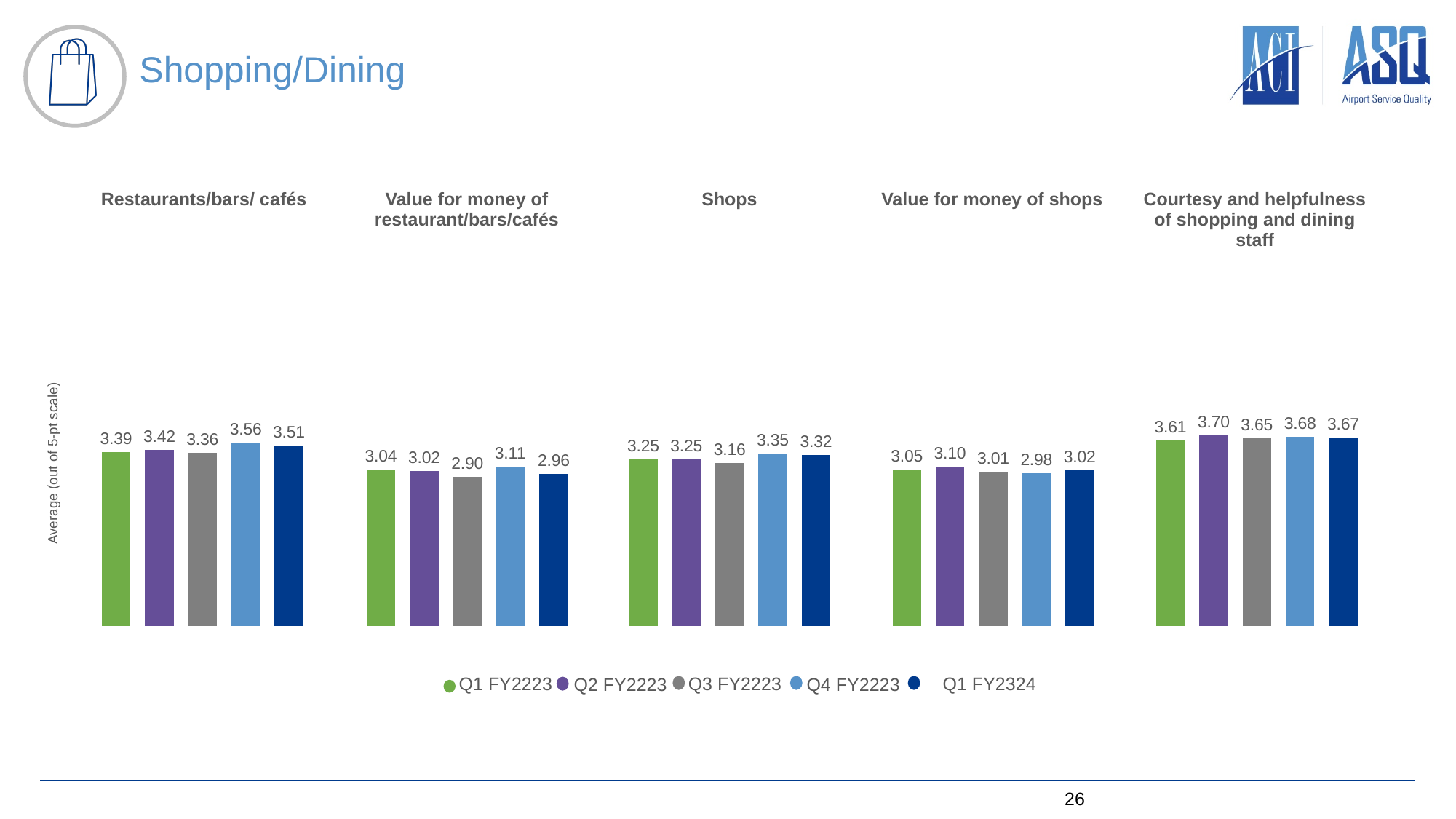
Which is larger in the Shops category: the Q3 FY2223 value or the Q4 FY2223 value? Q4 FY2223 How many categories are shown on the chart? 5 What is the value for Q1 FY2324 in the Shops category? 3.32 What kind of chart is shown on the slide? Bar chart What is the difference between the Q4 FY2223 and Q1 FY2324 values in the Restaurants/bars/ cafés category? 0.05 Which series has the lowest value in the Value for money of shops category? Q4 FY2223 What is the label of the vertical axis? Average (out of 5-pt scale) Which series has the highest value in the Courtesy and helpfulness of shopping and dining staff category? Q2 FY2223 What is the difference between the Q2 FY2223 and Q3 FY2223 values in the Value for money of shops category? 0.09 What is the value for Q4 FY2223 in the Restaurants/bars/ cafés category? 3.56 What is the value for Q3 FY2223 in the Value for money of restaurant/bars/cafés category? 2.90 How many series does the legend list? 5